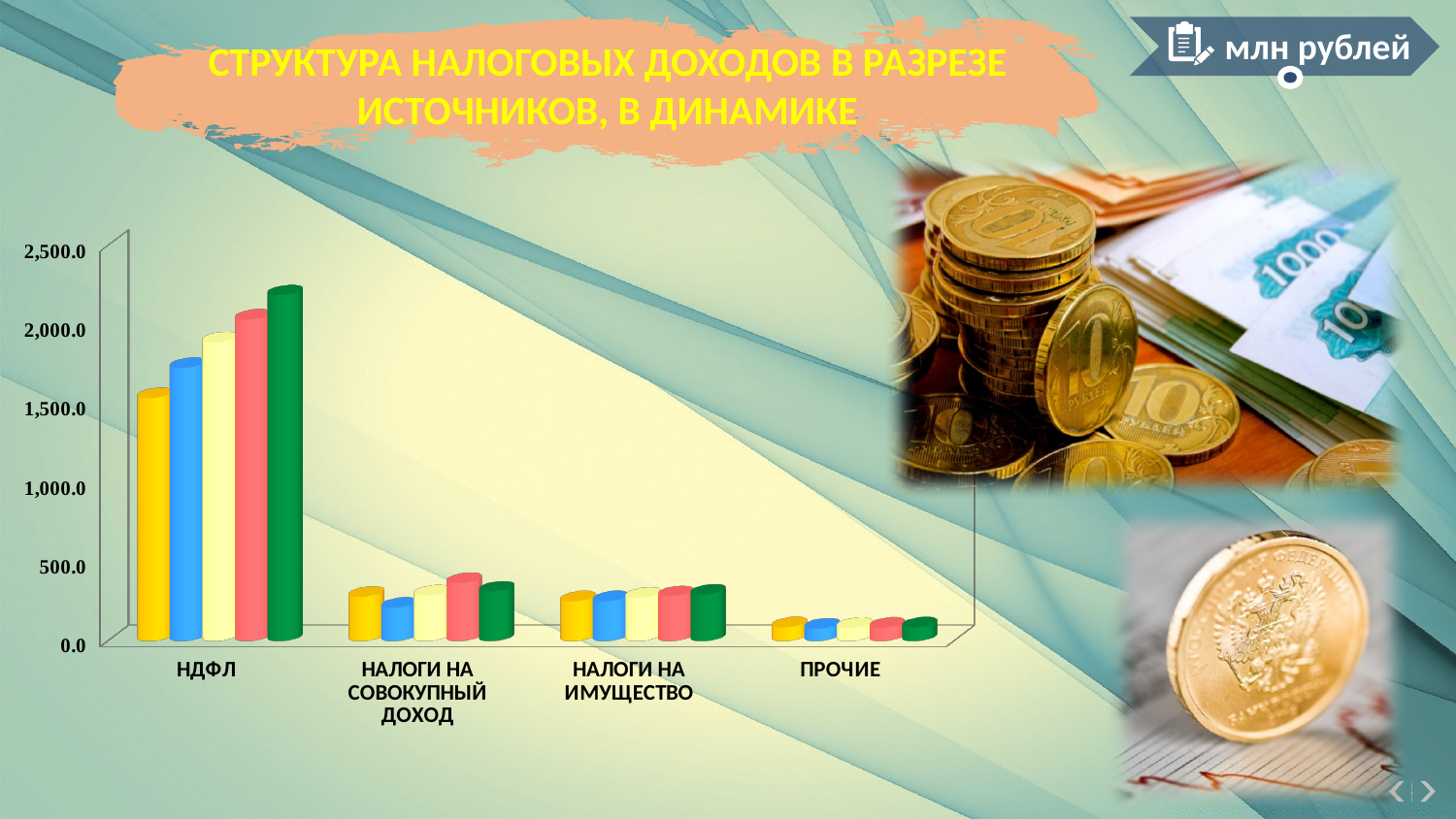
What kind of chart is shown on the slide? bar chart Which category has the lowest values in the chart? ПРОЧИЕ How many categories are shown on the x axis of the chart? 4 Which category has the highest values in the chart? НДФЛ In what unit are the values on the slide expressed, according to the label in the top right corner? млн рублей Which category has larger values, НДФЛ or НАЛОГИ НА ИМУЩЕСТВО? НДФЛ Is the value of the yellow (leftmost) bar for НДФЛ greater or less than 2,000.0? less How many bars are plotted for each category in the chart? 5 Do the bars for НДФЛ rise or fall from left to right within the category? rise What is the highest value shown on the vertical axis of the chart? 2,500.0 Are the values for ПРОЧИЕ greater or less than 500.0? less Is the value of the green (rightmost) bar for НДФЛ greater or less than 2,000.0? greater